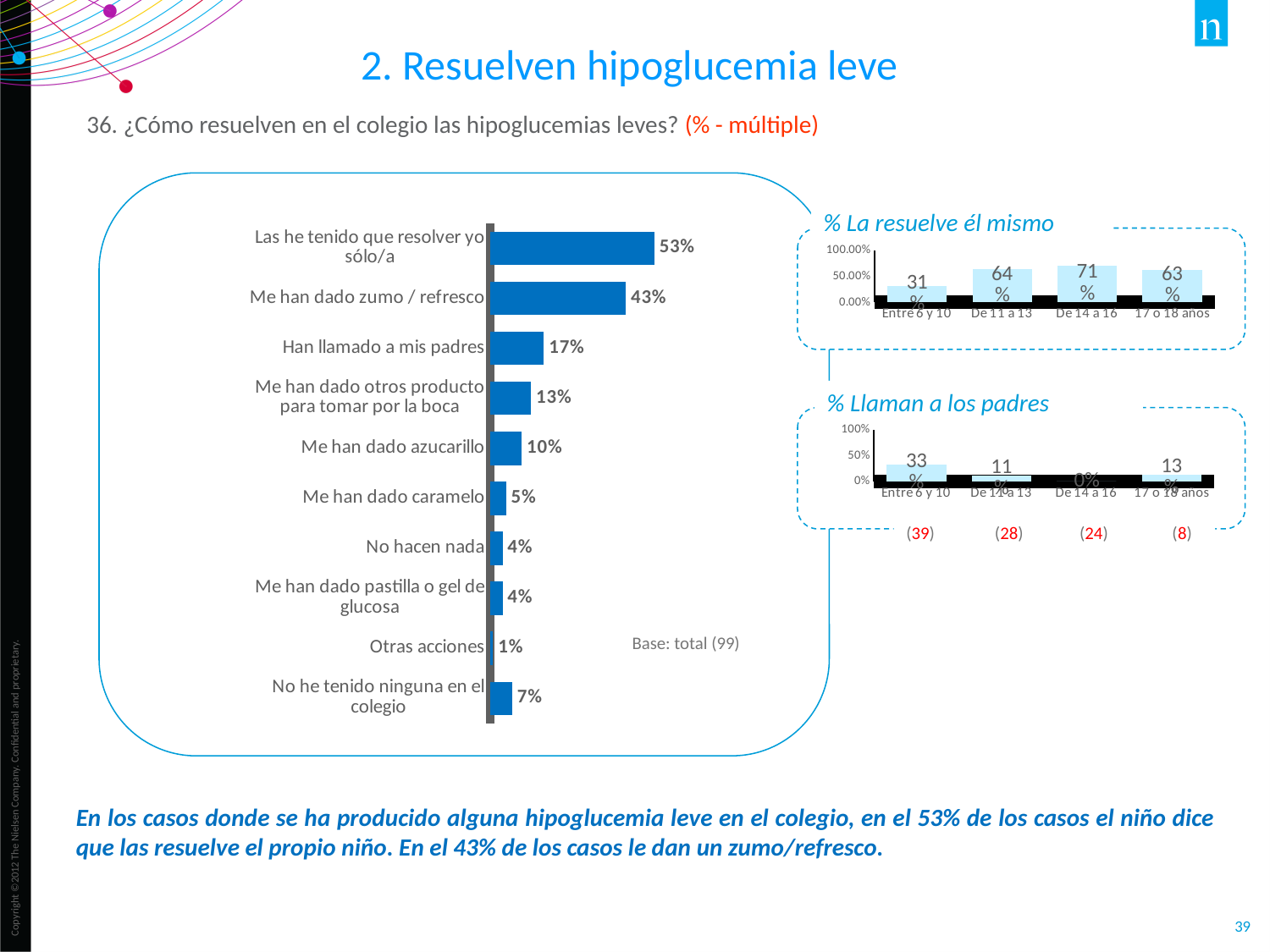
In the '% La resuelve él mismo' chart, what is the value for 'De 14 a 16'? 71% In the main bar chart, what is the difference between 'Las he tenido que resolver yo sólo/a' and 'Me han dado zumo / refresco'? 10% In the main bar chart, which category has the lowest value? Otras acciones In the '% La resuelve él mismo' chart, which age group has the lowest value? Entre 6 y 10 What type of chart is the main chart on the left of the slide? Bar chart In the '% Llaman a los padres' chart, what is the difference between 'Entre 6 y 10' and '17 o 18 años'? 20% In the main bar chart, which is larger: 'Me han dado azucarillo' or 'No he tenido ninguna en el colegio'? Me han dado azucarillo How many categories does the main bar chart show? 10 In the '% Llaman a los padres' chart, what is the value for 'Entre 6 y 10'? 33% In the main bar chart, which category has the highest value? Las he tenido que resolver yo sólo/a In the main bar chart, what percentage is shown for 'Me han dado zumo / refresco'? 43% In the main bar chart, what percentage is shown for 'Han llamado a mis padres'? 17%